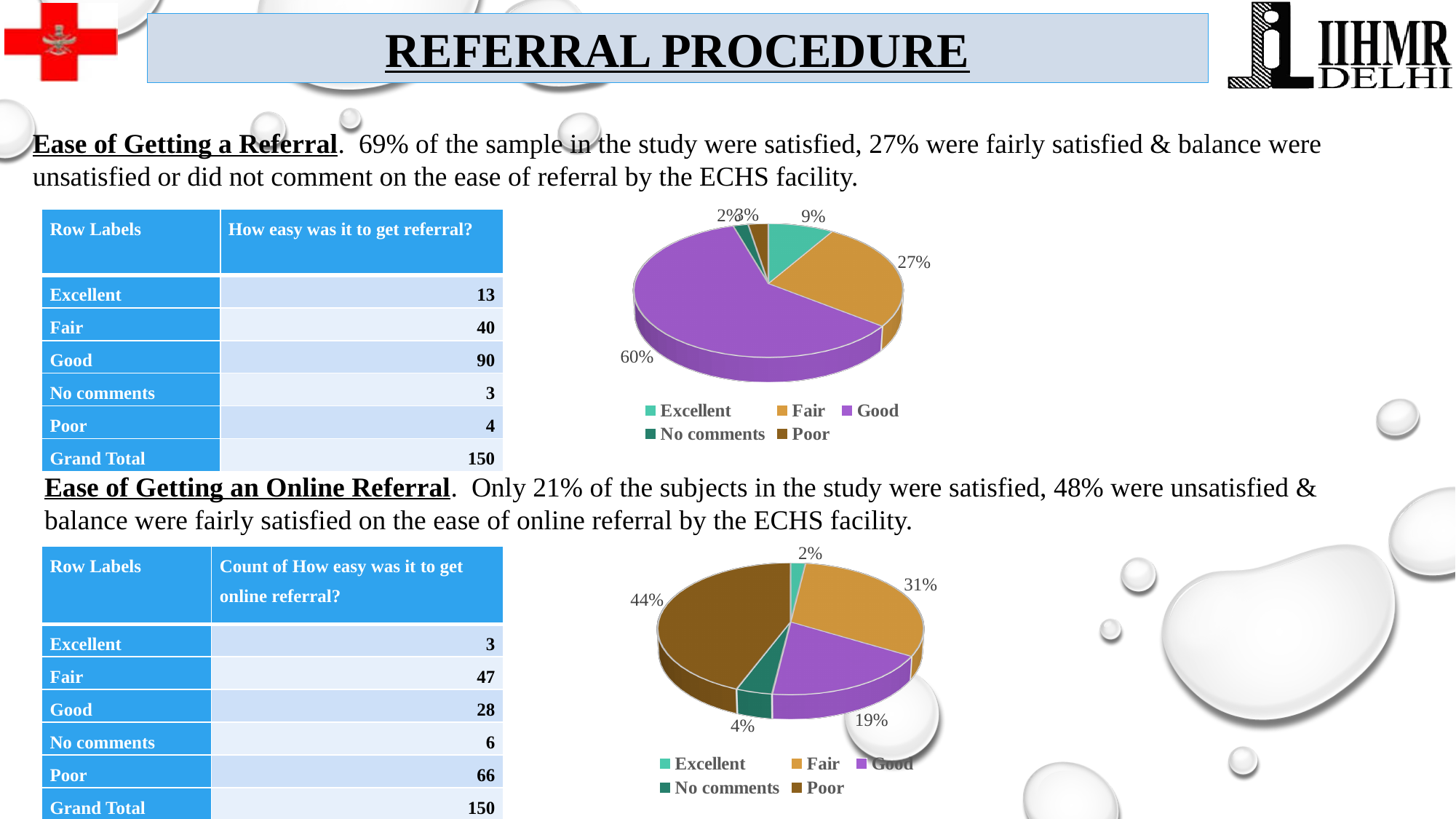
In the bottom pie chart (ease of getting an online referral), which category has the smallest slice? Excellent How many slices does the bottom pie chart have? 5 In the top pie chart (ease of getting a referral), what share does the Good slice have? 60% How many entries does the legend of the top pie chart list? 5 In the bottom pie chart (ease of getting an online referral), what share does the Poor slice have? 44% In the bottom pie chart (ease of getting an online referral), what is the difference between the Poor and Good shares? 25% In the top pie chart (ease of getting a referral), which category has the largest slice? Good In the top pie chart (ease of getting a referral), what is the difference between the Good and Fair shares? 33% What kind of chart is the top chart on the slide? pie chart In the bottom pie chart (ease of getting an online referral), what share does the Fair slice have? 31% In the bottom pie chart (ease of getting an online referral), which is larger, the Good slice or the Fair slice? Fair